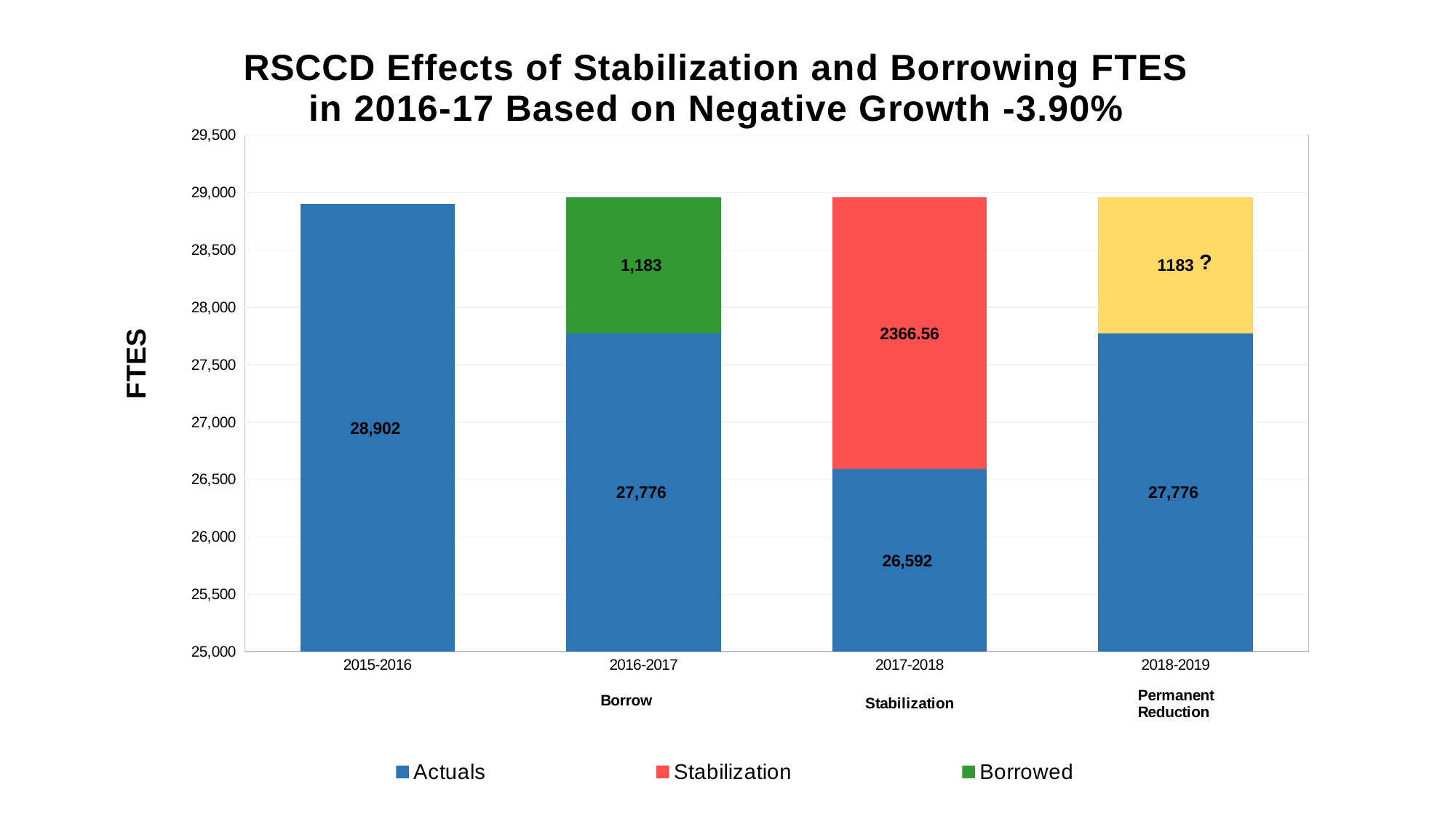
Which year has the highest Actuals value? 2015-2016 How many year categories are shown on the x axis? 4 What kind of chart is shown on the slide? Stacked bar chart What is the difference between the Actuals values for 2015-2016 and 2016-2017? 1,126 Which year has the lowest Actuals value? 2017-2018 What is the Stabilization value for 2017-2018? 2366.56 What is the Actuals value for 2015-2016? 28,902 Is the Actuals value for 2017-2018 greater or less than 27,000? less What is the Borrowed value for 2016-2017? 1,183 How many series does the legend list? 3 What is the total of the stacked bar for 2016-2017? 28,959 What is the Actuals value for 2017-2018? 26,592